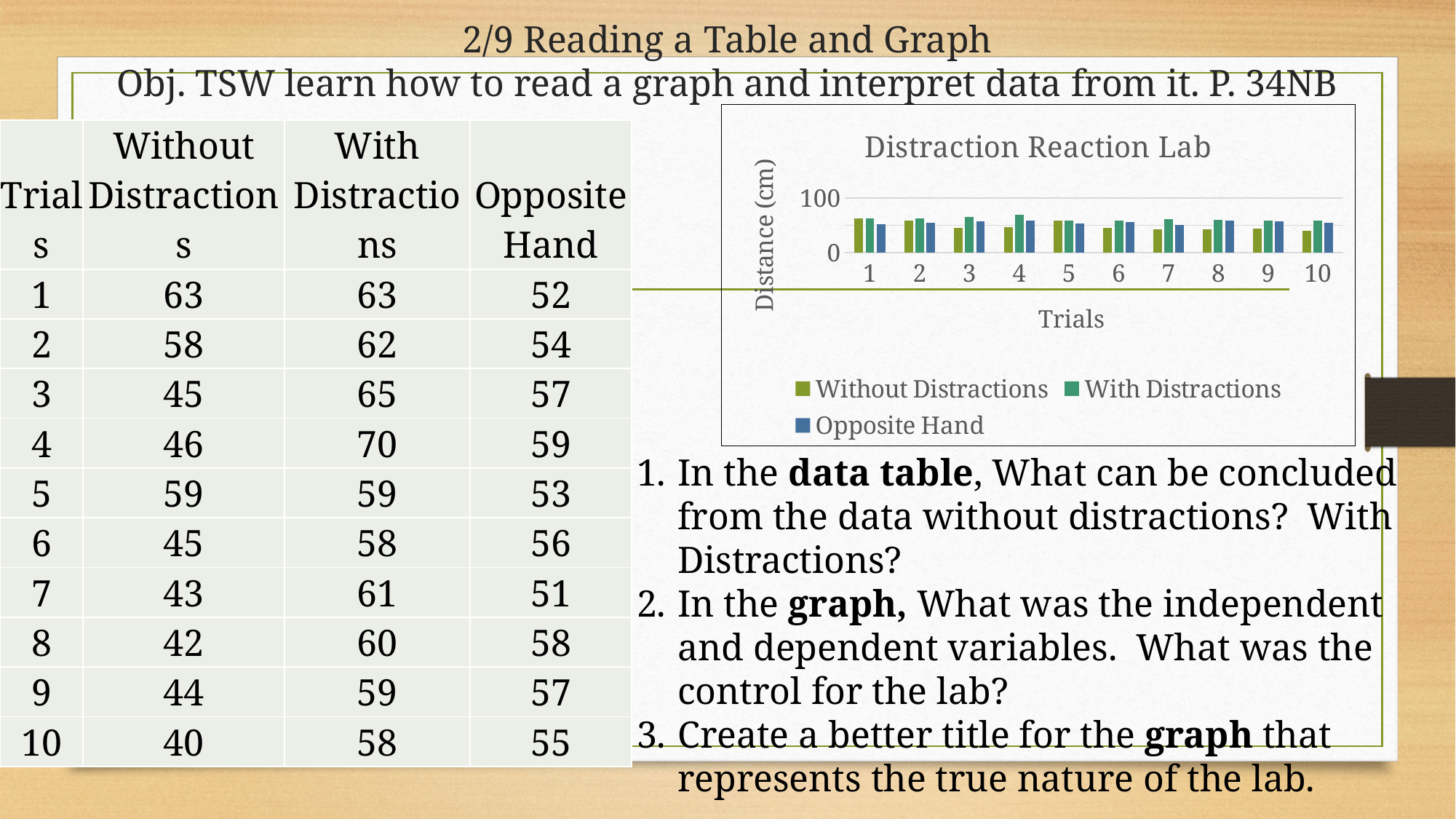
What is the title of the chart on the slide? Distraction Reaction Lab In the Distraction Reaction Lab chart, which is larger for trial 4: Without Distractions or With Distractions? With Distractions In the Distraction Reaction Lab chart, do the Without Distractions values generally rise or fall from trial 1 to trial 10? fall According to the data table on the slide, what is the With Distractions value for trial 4? 70 In the Distraction Reaction Lab chart, is the With Distractions value for trial 4 greater or less than 100? less What kind of chart is the Distraction Reaction Lab chart? bar chart According to the data table on the slide, what is the Without Distractions value for trial 1? 63 In the Distraction Reaction Lab chart, which is larger for trial 10: Without Distractions or With Distractions? With Distractions How many trials are shown on the x axis of the Distraction Reaction Lab chart? 10 According to the data table on the slide, what is the difference between the With Distractions and Without Distractions values for trial 10? 18 How many series does the legend of the Distraction Reaction Lab chart list? 3 What is the label of the vertical axis of the Distraction Reaction Lab chart? Distance (cm)